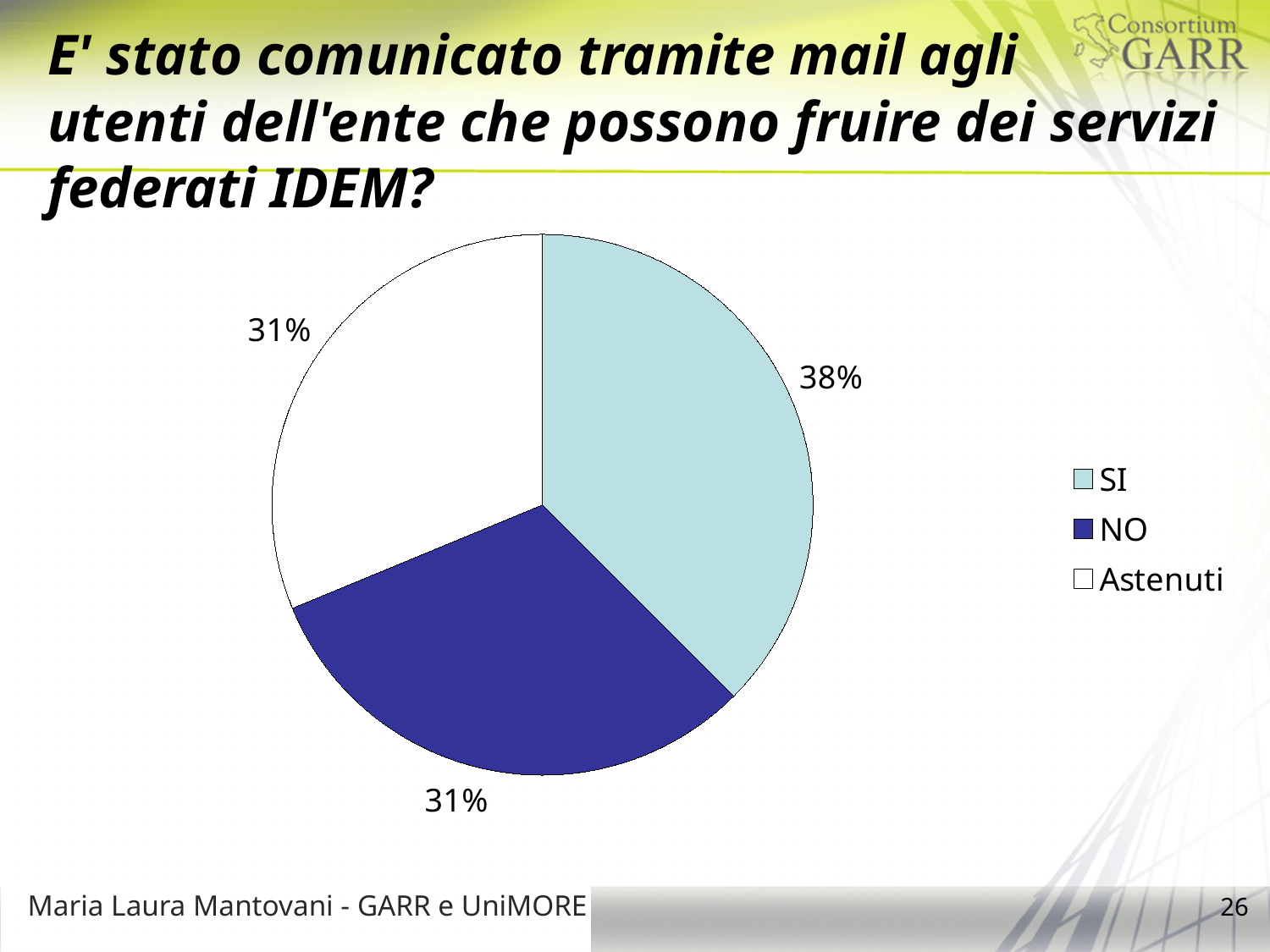
What colour is the Astenuti slice? white How many entries does the legend list? 3 What share of the pie does SI represent? 38% Which category has the largest slice of the pie? SI Which is larger, the SI slice or the Astenuti slice? SI What share of the pie does Astenuti represent? 31% What colour is the NO slice? dark blue How many slices does the pie chart have? 3 What share of the pie does NO represent? 31% What is the difference in percentage points between the SI slice and the NO slice? 7 What kind of chart is shown on the slide? pie chart